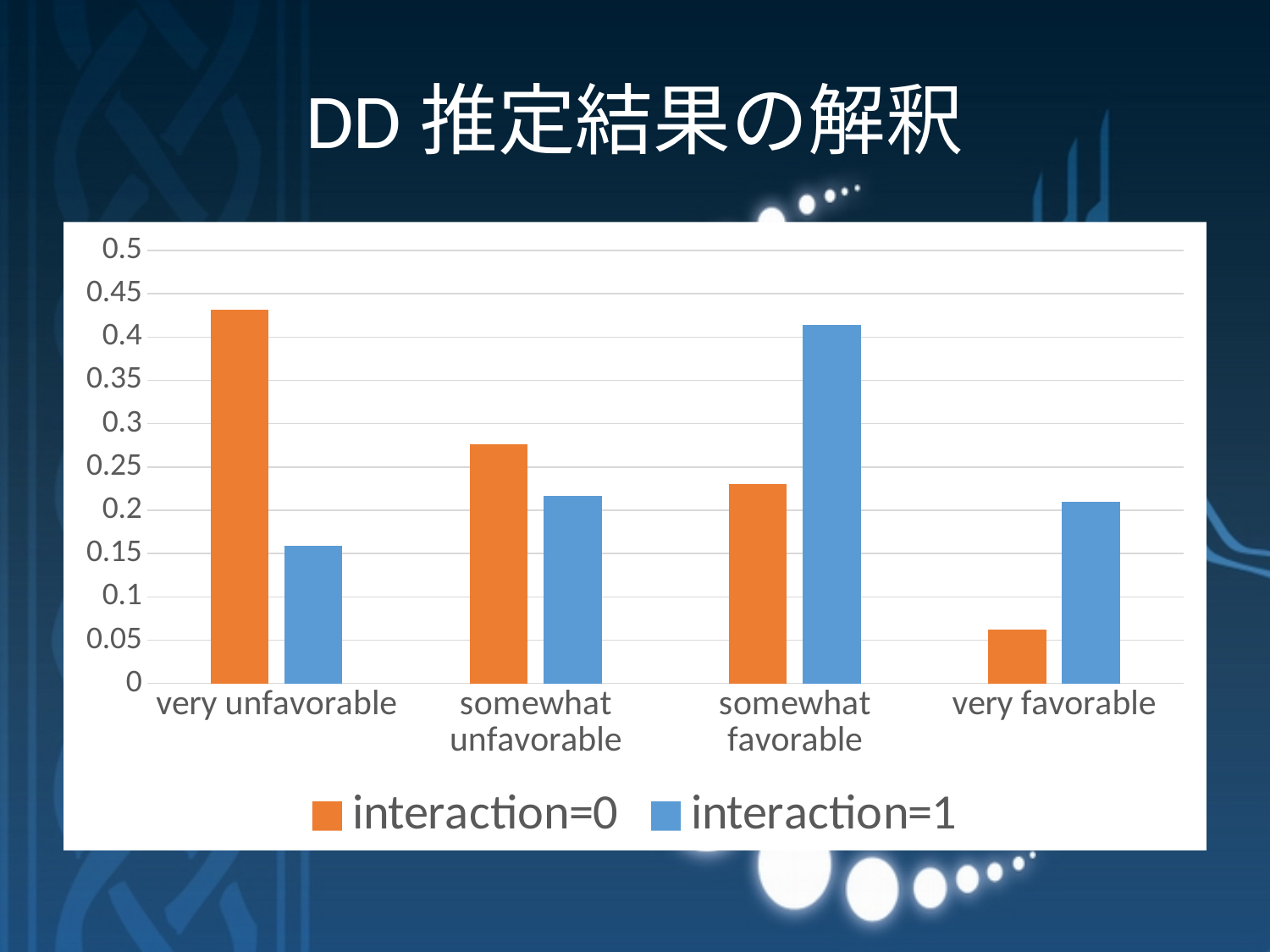
Which category has the highest value for interaction=1? somewhat favorable Is the interaction=0 value for very unfavorable greater or less than 0.4? greater Which category has the lowest value for interaction=1? very unfavorable What kind of chart is shown on the slide? bar chart For somewhat unfavorable, which series has the larger value, interaction=0 or interaction=1? interaction=0 Is the interaction=1 value for very unfavorable greater or less than 0.2? less Which category has the lowest value for interaction=0? very favorable Which category has the highest value for interaction=0? very unfavorable How many categories are shown on the x axis? 4 For very favorable, which series has the larger value, interaction=0 or interaction=1? interaction=1 Is the interaction=0 value for very favorable greater or less than 0.1? less How many series does the legend list? 2